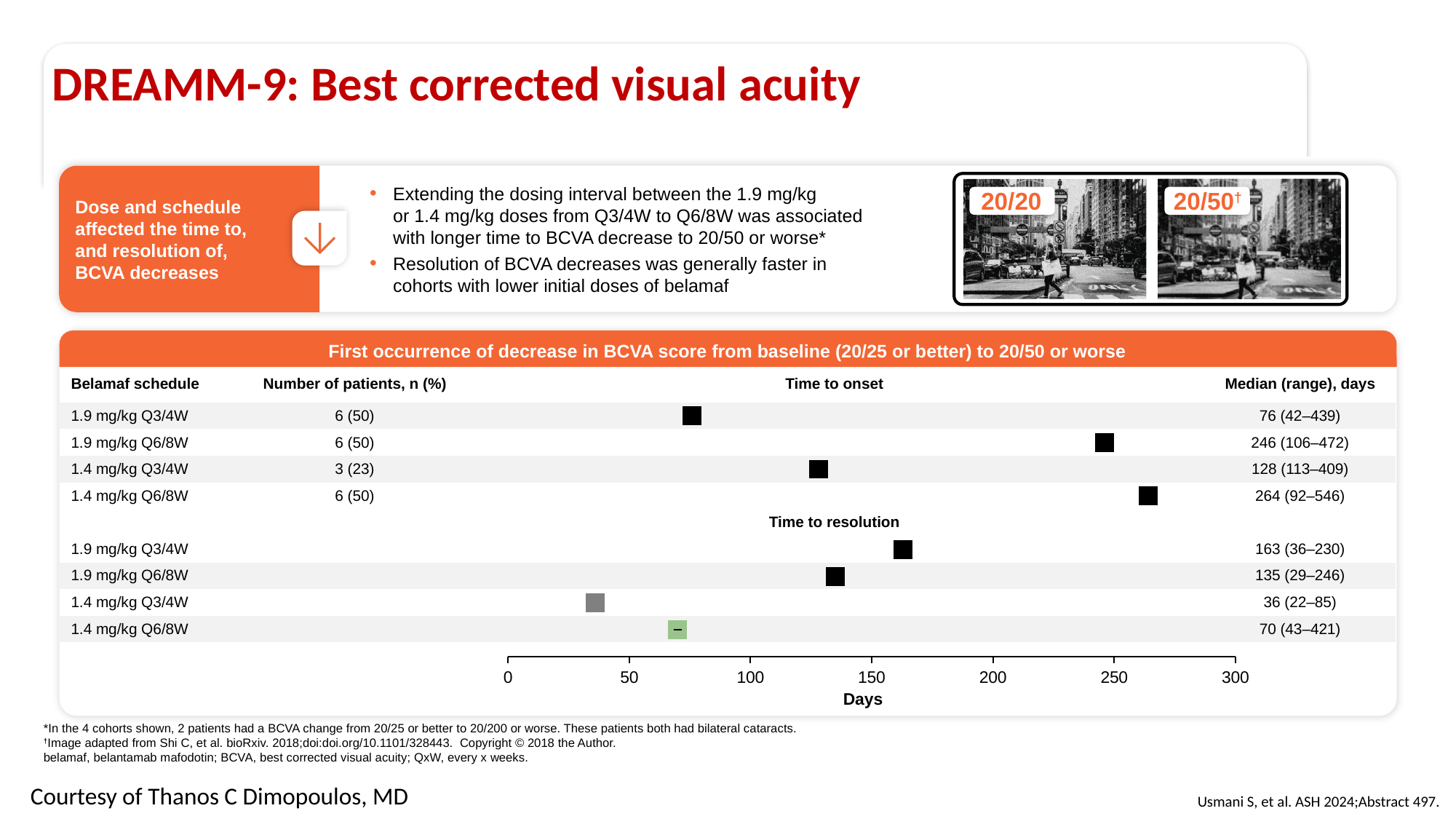
What is the difference in median time to onset between the 1.9 mg/kg Q6/8W and 1.9 mg/kg Q3/4W schedules, in days? 170 Which belamaf schedule has the longest median time to onset? 1.4 mg/kg Q6/8W Which belamaf schedule has the shortest median time to resolution? 1.4 mg/kg Q3/4W Is the median time to onset for the 1.4 mg/kg Q3/4W schedule greater or less than 100 days? greater What is the title of the chart/table on the slide? First occurrence of decrease in BCVA score from baseline (20/25 or better) to 20/50 or worse How many belamaf schedules are plotted in the Time to onset section? 4 How many patients (n) had a BCVA decrease to 20/50 or worse in the 1.4 mg/kg Q3/4W cohort? 3 (23) Is the median time to resolution for the 1.4 mg/kg Q6/8W schedule greater or less than 100 days? less What is the maximum value shown on the Days axis? 300 What is the median time to onset, in days, for the 1.9 mg/kg Q6/8W schedule? 246 What is the median (range) time to resolution, in days, for the 1.4 mg/kg Q3/4W schedule? 36 (22–85) Which has a longer median time to resolution: 1.9 mg/kg Q3/4W or 1.9 mg/kg Q6/8W? 1.9 mg/kg Q3/4W